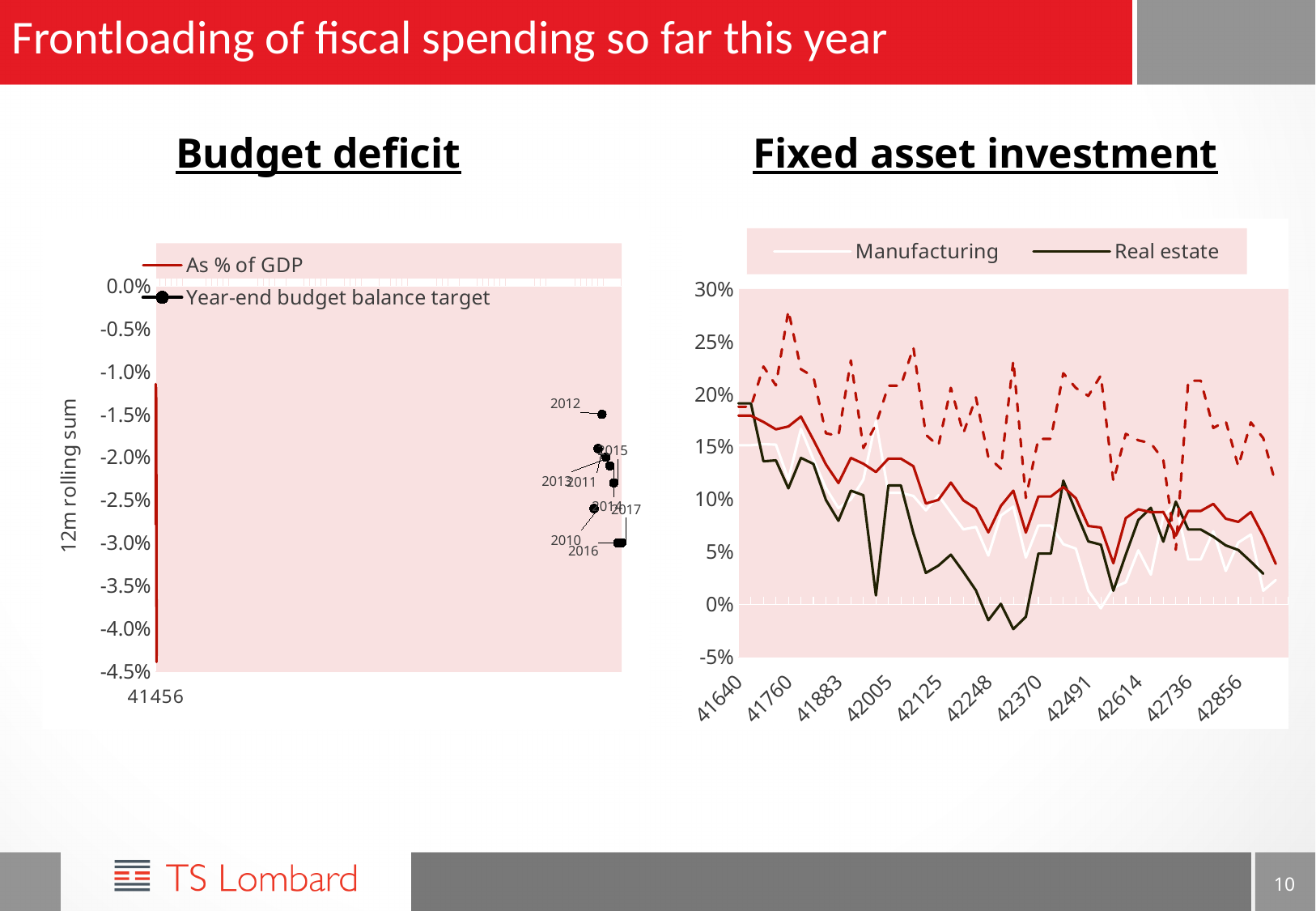
In the Fixed asset investment chart, does the Real estate line ever drop below 0%? yes How many series does the legend of the Fixed asset investment chart list? 2 What kind of chart is the Fixed asset investment chart? line chart In the Fixed asset investment chart, does the Real estate line rise or fall overall from left to right? fall What is the y-axis label of the Budget deficit chart? 12m rolling sum What is the highest value shown on the y-axis of the Fixed asset investment chart? 30% In the Fixed asset investment chart, is the Real estate value at the first point (41640) greater or less than 15%? greater In the Fixed asset investment chart, is the Manufacturing value at the last point greater or less than 5%? less In the Fixed asset investment chart, which series is higher at the first point (41640), Manufacturing or Real estate? Real estate How many series does the legend of the Budget deficit chart list? 2 How many labels are shown on the x-axis of the Fixed asset investment chart? 11